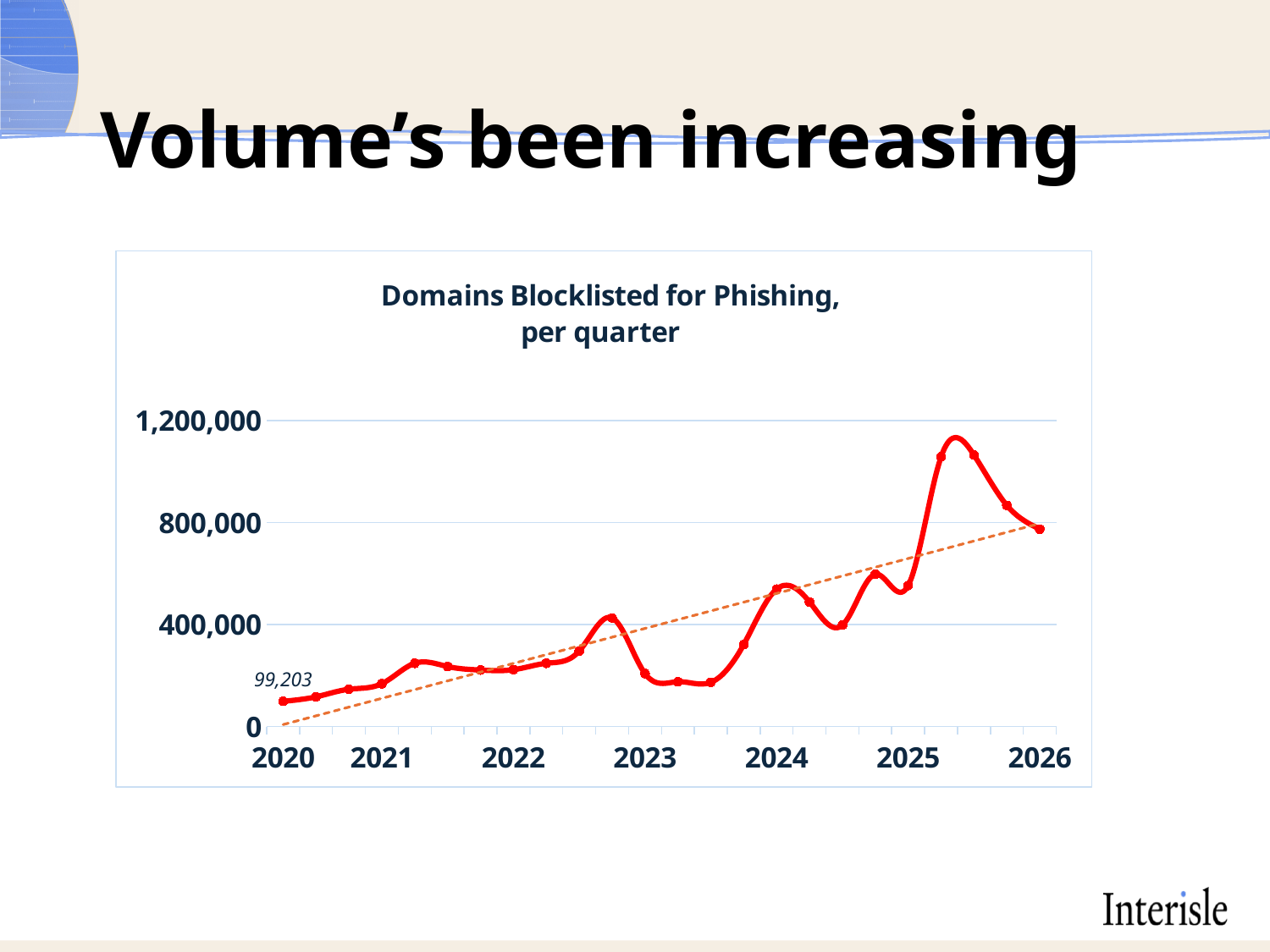
What type of chart is shown on the slide? line chart In which year does the line have its lowest point? 2020 What is the title of the chart? Domains Blocklisted for Phishing, per quarter Overall, do the values rise or fall from 2020 to 2026? rise Is the highest point of the line, in 2025, greater or less than 800,000? greater What value is labelled on the first data point of the line, at 2020? 99,203 Is the value at the start of 2020 greater or less than 400,000? less In which year does the line reach its highest point? 2025 How many year labels are shown on the x axis? 7 Is the value at the start of 2024 greater or less than 400,000? greater Which is larger, the value at the start of 2024 or the value at the start of 2023? 2024